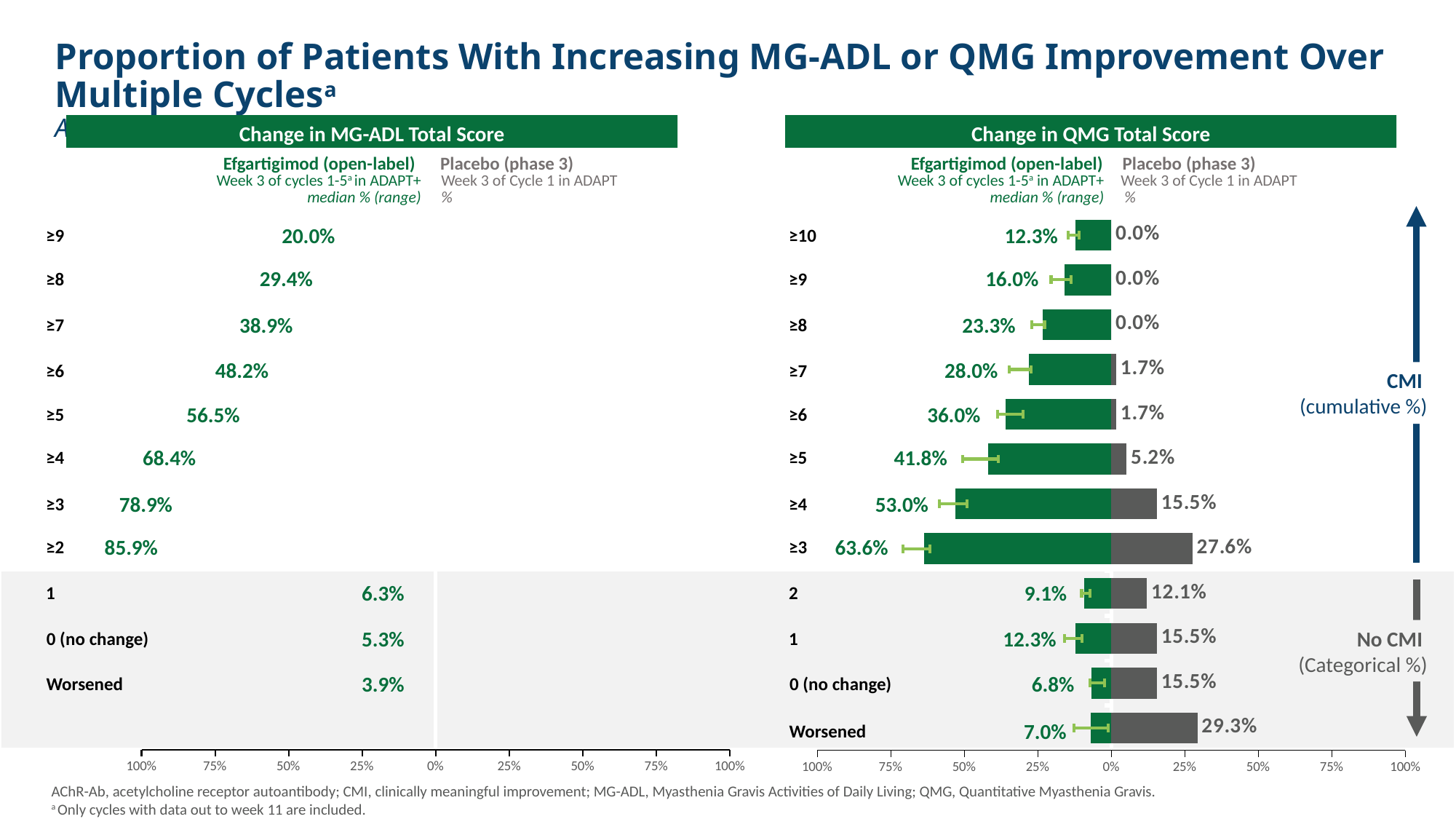
In the Change in QMG Total Score chart, what is the placebo value for the ≥3 category? 27.6% In the Change in MG-ADL Total Score chart, what is the difference between the efgartigimod values for ≥2 and ≥9? 65.9 percentage points How many categories are listed in the Change in MG-ADL Total Score chart? 11 In the Change in QMG Total Score chart, what is the placebo value for the ≥8 category? 0.0% In the Change in QMG Total Score chart, for the ≥4 category, which is larger: the efgartigimod value or the placebo value? Efgartigimod In the Change in QMG Total Score chart, what is the difference between the efgartigimod and placebo values for the ≥3 category? 36.0 percentage points In the Change in QMG Total Score chart, which category has the highest placebo value? Worsened In the Change in MG-ADL Total Score chart, what is the efgartigimod value for the Worsened category? 3.9% In the Change in QMG Total Score chart, what is the efgartigimod value for the ≥10 category? 12.3% In the Change in QMG Total Score chart, do the efgartigimod cumulative values increase or decrease going from ≥10 down to ≥3? Increase In the Change in MG-ADL Total Score chart, what is the efgartigimod value for the ≥2 category? 85.9% In the Change in QMG Total Score chart, which CMI (cumulative %) category has the lowest efgartigimod value? ≥10